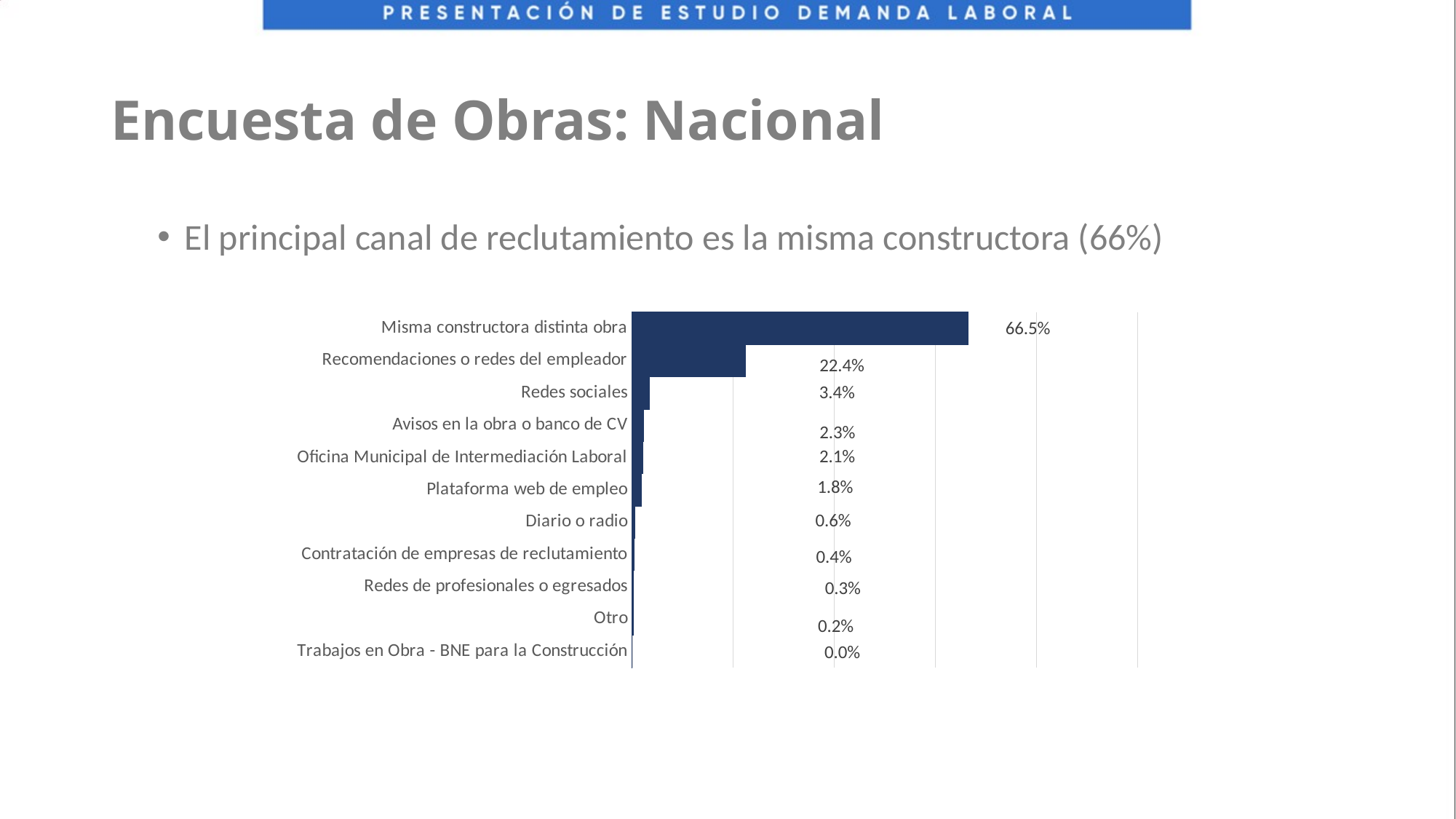
Which category has the highest value? Misma constructora distinta obra Which category has the lowest value? Trabajos en Obra - BNE para la Construcción What is the value for Misma constructora distinta obra? 66.5% What is the difference between the values for Misma constructora distinta obra and Recomendaciones o redes del empleador? 44.1% Which is larger, the value for Avisos en la obra o banco de CV or the value for Plataforma web de empleo? Avisos en la obra o banco de CV What is the difference between the values for Diario o radio and Otro? 0.4% What is the value for Trabajos en Obra - BNE para la Construcción? 0.0% How many categories are shown in the chart? 11 What kind of chart is shown on the slide? Bar chart What is the value for Recomendaciones o redes del empleador? 22.4% What is the value for Redes sociales? 3.4% What is the value for Oficina Municipal de Intermediación Laboral? 2.1%